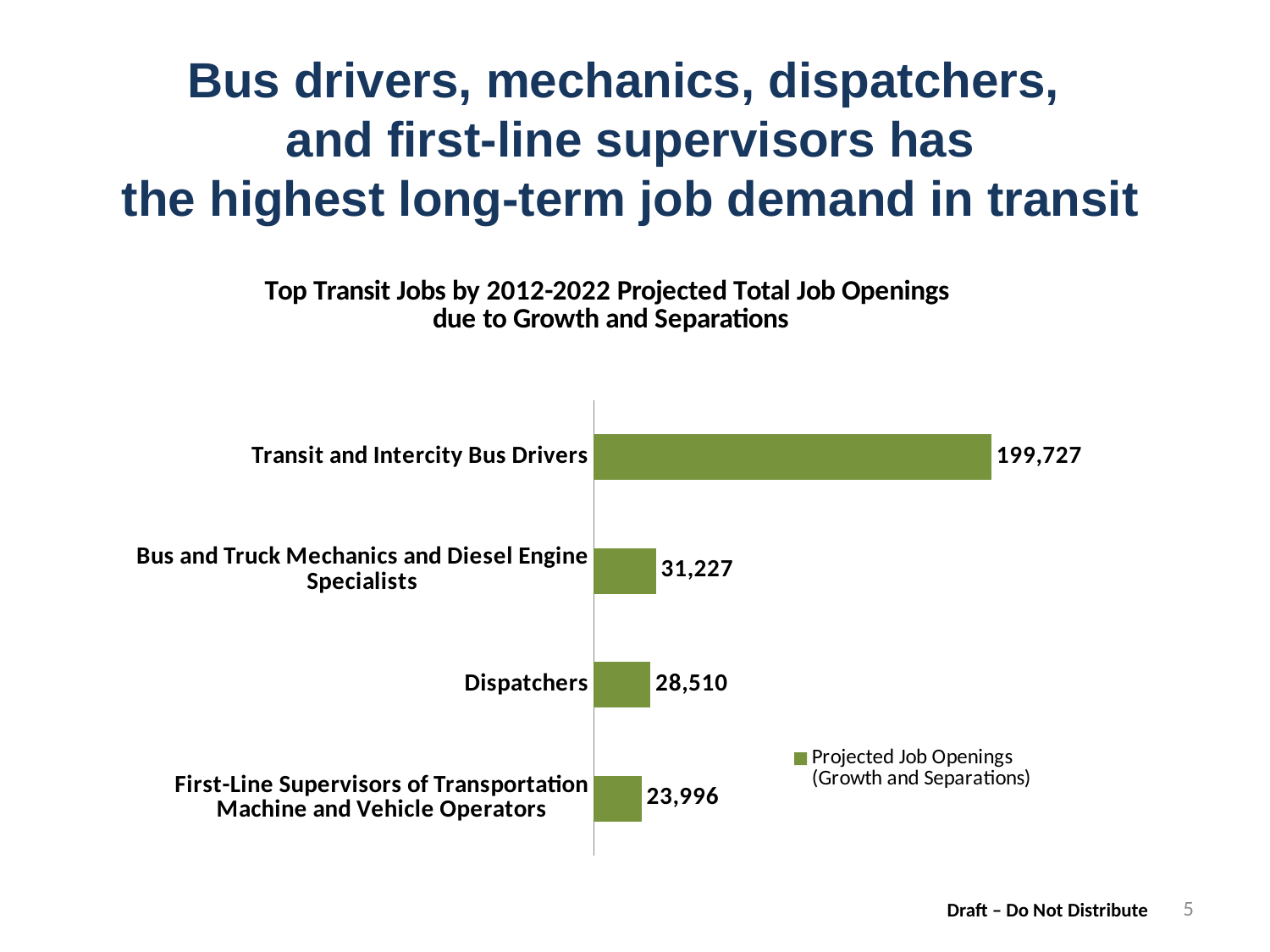
What is the projected job openings value for Dispatchers? 28,510 What is the projected job openings value for Transit and Intercity Bus Drivers? 199,727 How many job categories are shown in the chart? 4 Which job category has the highest projected job openings? Transit and Intercity Bus Drivers Which has more projected job openings: Dispatchers or Bus and Truck Mechanics and Diesel Engine Specialists? Bus and Truck Mechanics and Diesel Engine Specialists What is the title of the chart? Top Transit Jobs by 2012-2022 Projected Total Job Openings due to Growth and Separations What is the projected job openings value for First-Line Supervisors of Transportation Machine and Vehicle Operators? 23,996 What is the difference in projected job openings between Transit and Intercity Bus Drivers and Dispatchers? 171,217 What is the difference in projected job openings between Bus and Truck Mechanics and Diesel Engine Specialists and First-Line Supervisors of Transportation Machine and Vehicle Operators? 7,231 Which job category has the lowest projected job openings? First-Line Supervisors of Transportation Machine and Vehicle Operators What type of chart is shown on the slide? Bar chart What is the projected job openings value for Bus and Truck Mechanics and Diesel Engine Specialists? 31,227